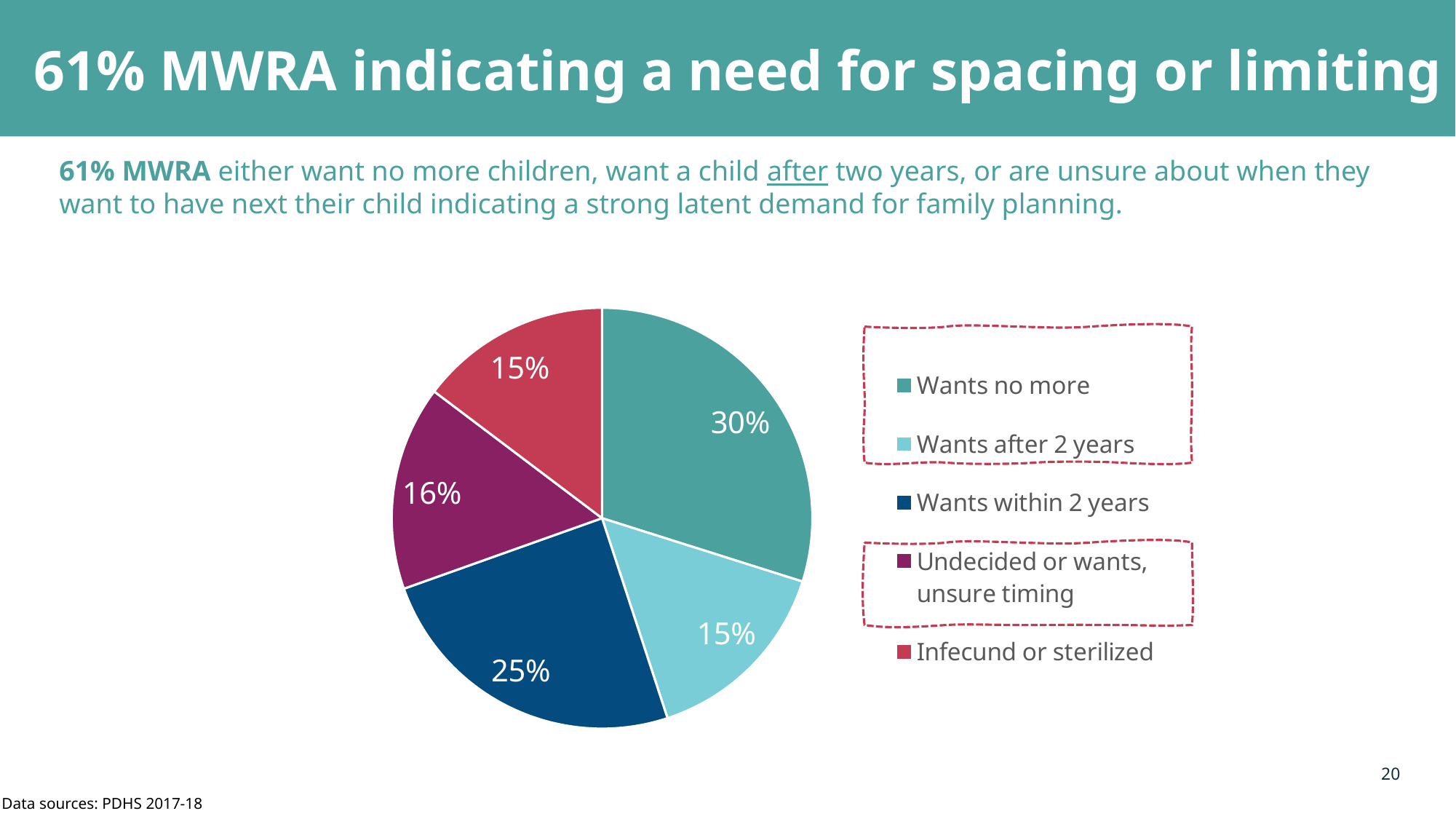
Which is larger: the 'Wants within 2 years' slice or the 'Undecided or wants, unsure timing' slice? Wants within 2 years What share of the pie is labelled 'Wants after 2 years'? 15% How many entries does the legend list? 5 What share of the pie is labelled 'Infecund or sterilized'? 15% What share of the pie is labelled 'Wants within 2 years'? 25% What kind of chart is shown on the slide? Pie chart Which category has the largest slice of the pie? Wants no more What share of the pie is labelled 'Undecided or wants, unsure timing'? 16% What is the difference between the 'Wants no more' slice and the 'Wants within 2 years' slice? 5% Which legend entries are enclosed in red dashed boxes? Wants no more, Wants after 2 years, and Undecided or wants, unsure timing How many slices does the pie chart have? 5 What share of the pie is labelled 'Wants no more'? 30%